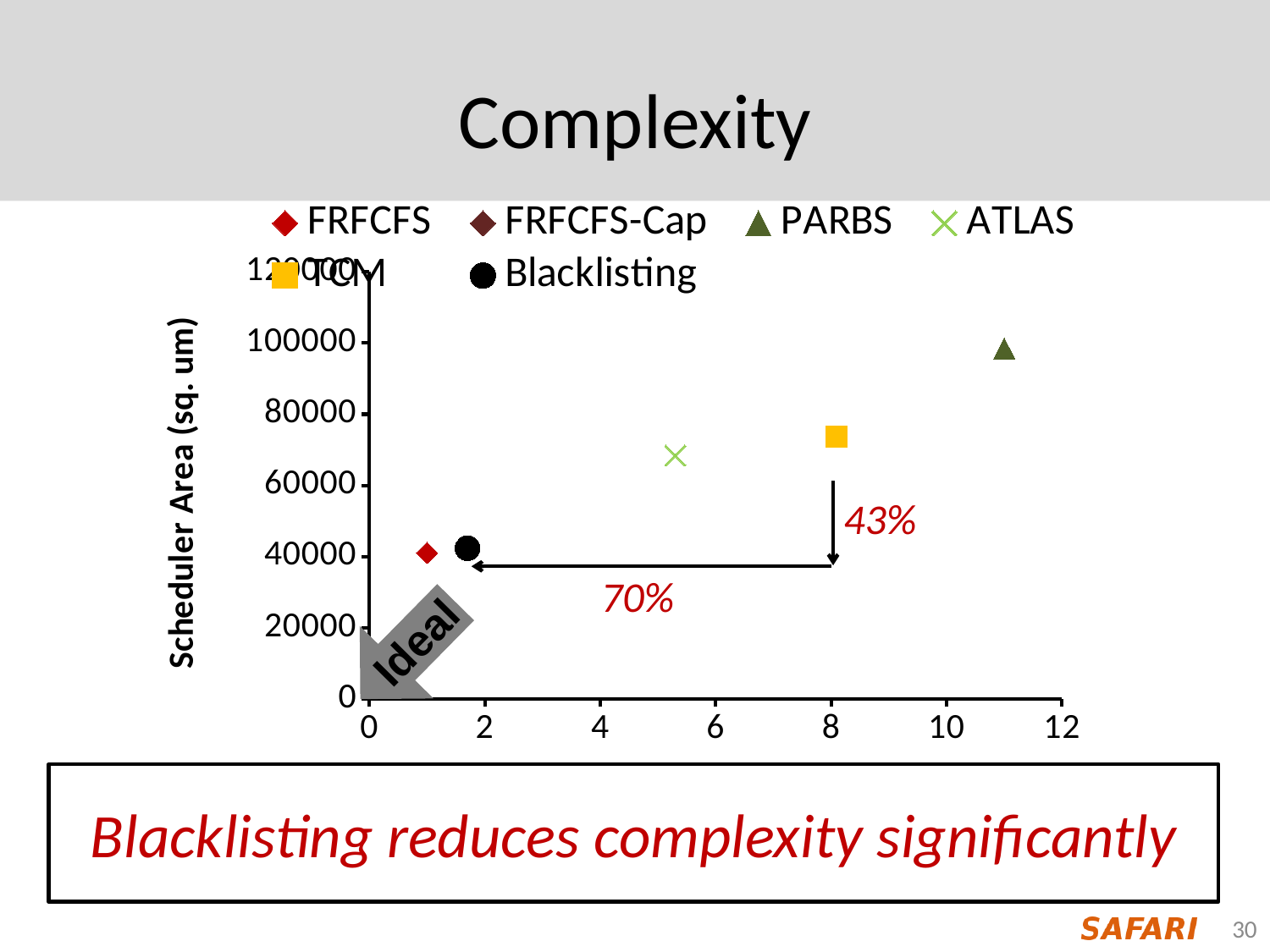
Is the scheduler area for TCM greater or less than 60000? greater Which has a larger scheduler area, ATLAS or Blacklisting? ATLAS What kind of chart is shown on the slide? scatter chart Is the scheduler area for Blacklisting greater or less than 60000? less Is the scheduler area for PARBS greater or less than 80000? greater Which has a larger scheduler area, PARBS or TCM? PARBS How many series does the legend list? 6 What is the label of the y axis? Scheduler Area (sq. um) What percentage is written next to the vertical arrow pointing down from the TCM point? 43% Which series has the highest scheduler area? PARBS